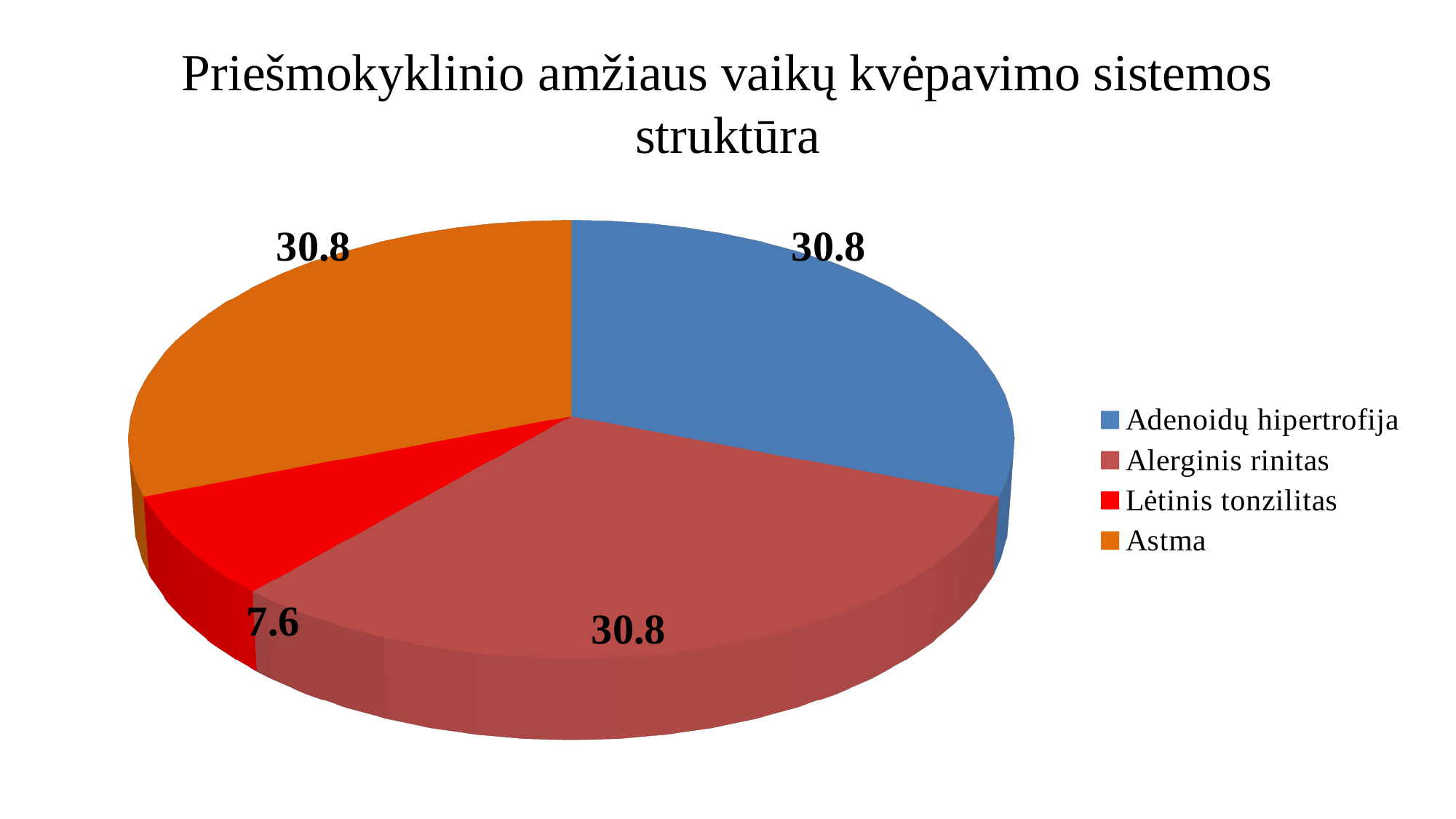
What value is shown for Lėtinis tonzilitas? 7.6 What kind of chart is shown on the slide? Pie chart What value is shown for Alerginis rinitas? 30.8 What value is shown for Adenoidų hipertrofija? 30.8 How many entries does the legend list? 4 Which category has the smallest slice of the pie? Lėtinis tonzilitas Which is larger, the value for Alerginis rinitas or the value for Lėtinis tonzilitas? Alerginis rinitas What is the title of the chart? Priešmokyklinio amžiaus vaikų kvėpavimo sistemos struktūra What value is shown for Astma? 30.8 How many categories are shown in the pie chart? 4 What colour is the slice for Astma? Orange What is the difference between the values for Astma and Lėtinis tonzilitas? 23.2